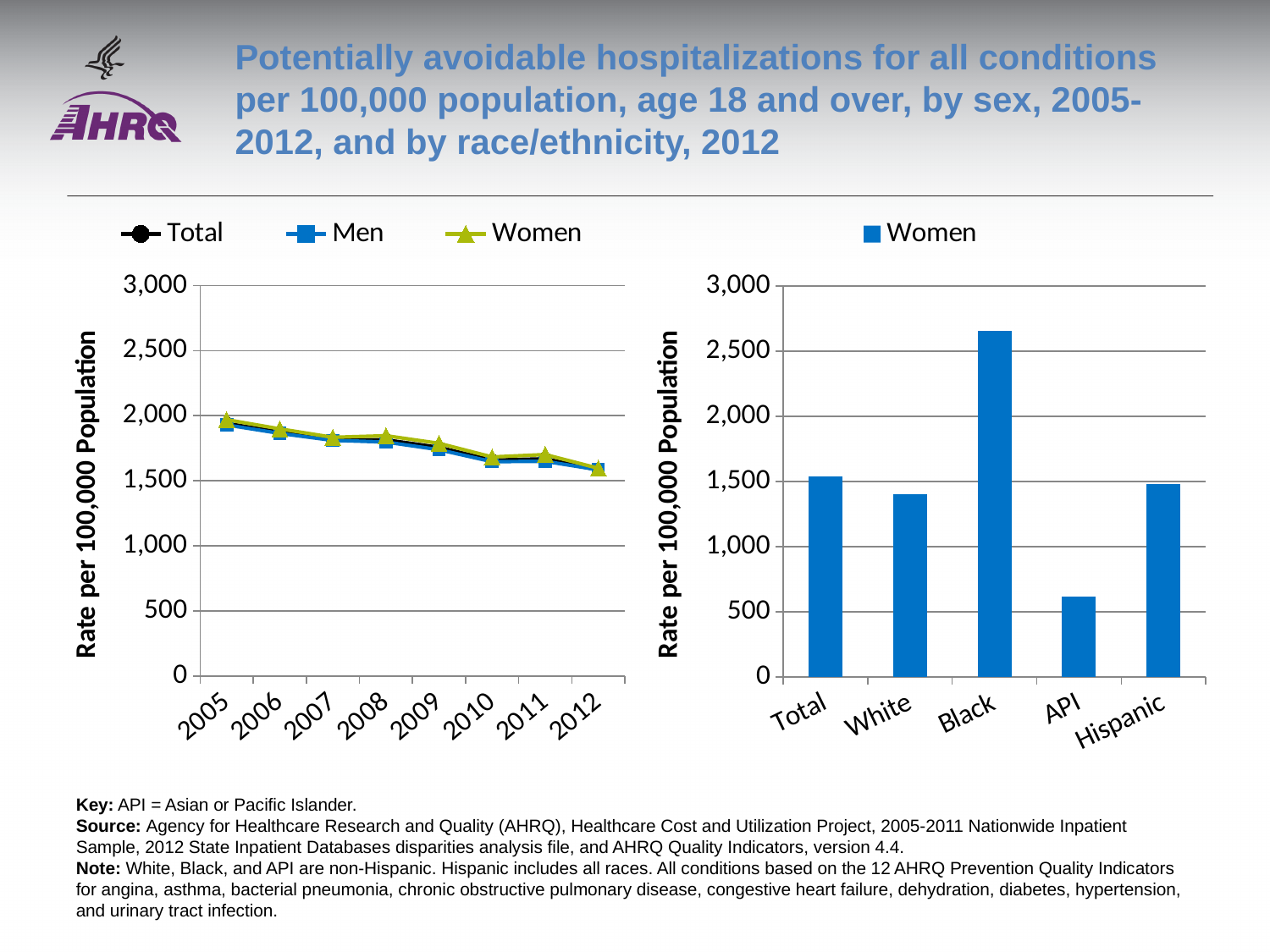
In the left chart, is the value for Total in 2012 greater or less than 2,000? less In the left chart, is the value for Women in 2005 greater or less than 1,500? greater What kind of chart is the left chart showing rates by sex from 2005 to 2012? line chart In the right chart, which race/ethnicity group has the lowest rate? API What kind of chart is the right chart showing rates by race/ethnicity in 2012? bar chart In the right chart, is the value for API greater or less than 1,000? less How many years are plotted on the x axis of the left chart? 8 In the left chart, do the rates rise or fall from 2005 to 2012? fall How many series does the legend of the left chart list? 3 In the right chart, which is larger, the value for Black or the value for White? Black In the right chart, which race/ethnicity group has the highest rate? Black